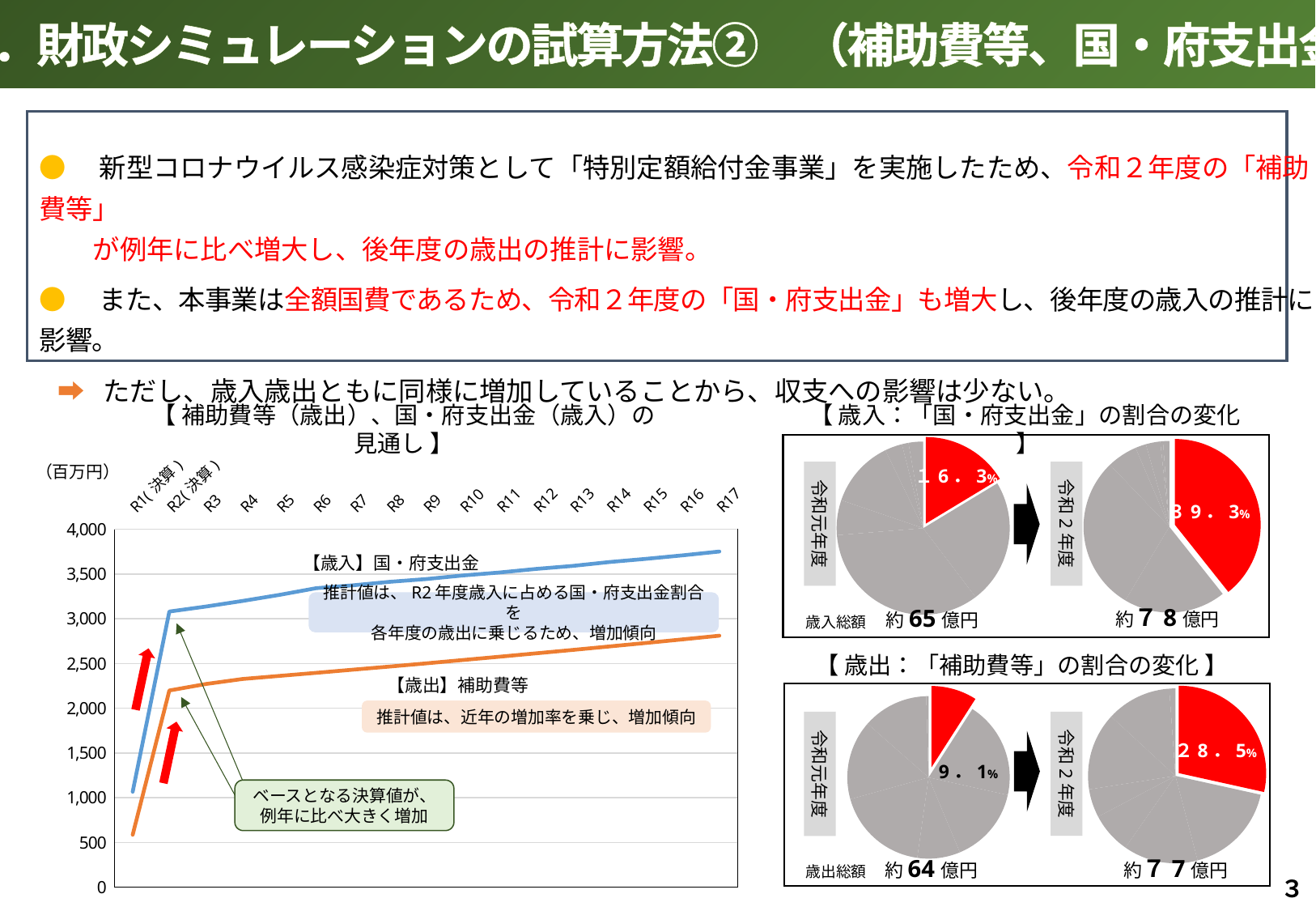
What kind of chart is the chart titled 【補助費等（歳出）、国・府支出金（歳入）の見通し】? line chart In the line chart 【補助費等（歳出）、国・府支出金（歳入）の見通し】, do the values of 【歳入】国・府支出金 rise or fall from R2(決算) to R17? rise In the pie charts 【歳出：「補助費等」の割合の変化】, by how many percentage points does the 補助費等 share in 令和2年度 exceed that in 令和元年度? 19.4 In the line chart 【補助費等（歳出）、国・府支出金（歳入）の見通し】, is the value of 【歳出】補助費等 at R17 greater or less than 2,500? greater In the line chart 【補助費等（歳出）、国・府支出金（歳入）の見通し】, how many fiscal-year categories are shown on the x axis? 17 In the pie charts 【歳入：「国・府支出金」の割合の変化】, what is the 歳入総額 shown for 令和2年度? 約78億円 In the line chart 【補助費等（歳出）、国・府支出金（歳入）の見通し】, what unit is shown for the y axis? 百万円 In the pie charts 【歳入：「国・府支出金」の割合の変化】, what share does 国・府支出金 have in 令和元年度? 16.3% In the pie charts 【歳出：「補助費等」の割合の変化】, what share does 補助費等 have in 令和元年度? 9.1% In the pie charts 【歳入：「国・府支出金」の割合の変化】, what share does 国・府支出金 have in 令和2年度? 39.3% In the line chart 【補助費等（歳出）、国・府支出金（歳入）の見通し】, which series is higher at R17, 【歳入】国・府支出金 or 【歳出】補助費等? 【歳入】国・府支出金 In the line chart 【補助費等（歳出）、国・府支出金（歳入）の見通し】, is the value of 【歳入】国・府支出金 at R17 greater or less than 3,500? greater